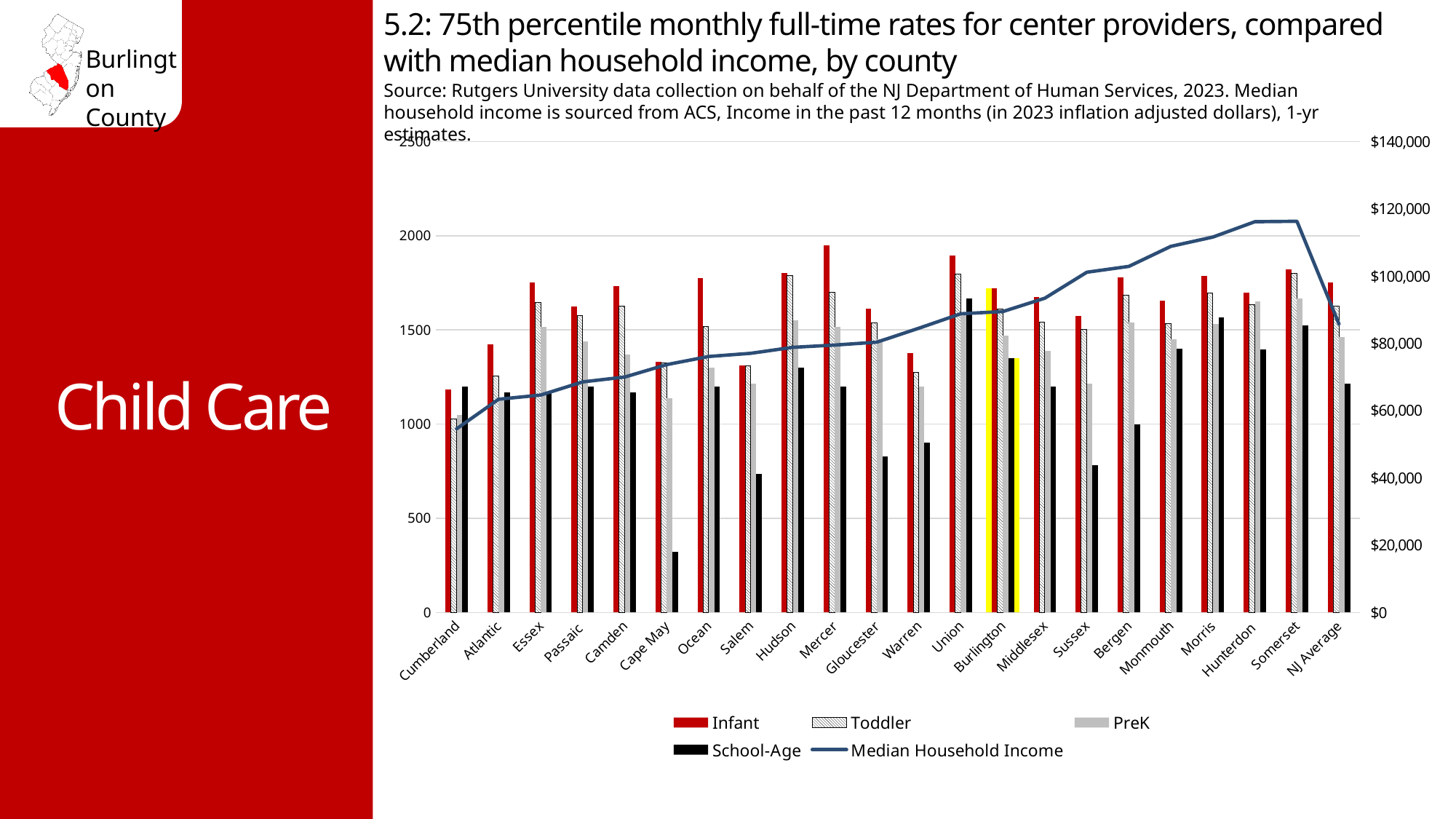
Which category has the highest Infant rate? Mercer How many series does the legend list? 5 Which category has the lowest Infant rate? Cumberland Which series is plotted as a line rather than bars? Median Household Income What kind of chart is shown on the slide? Bar chart with a line series How many counties/categories are shown along the x axis? 22 Is the Infant rate for Cumberland greater or less than 1500? less Is the School-Age rate for Cape May greater or less than 500? less Which is larger, the Infant rate for Mercer or the Infant rate for Cumberland? Mercer Which category has the lowest School-Age rate? Cape May Is the Median Household Income for Somerset greater or less than $100,000? greater Does the Median Household Income line generally rise or fall from Cumberland to Somerset? rise